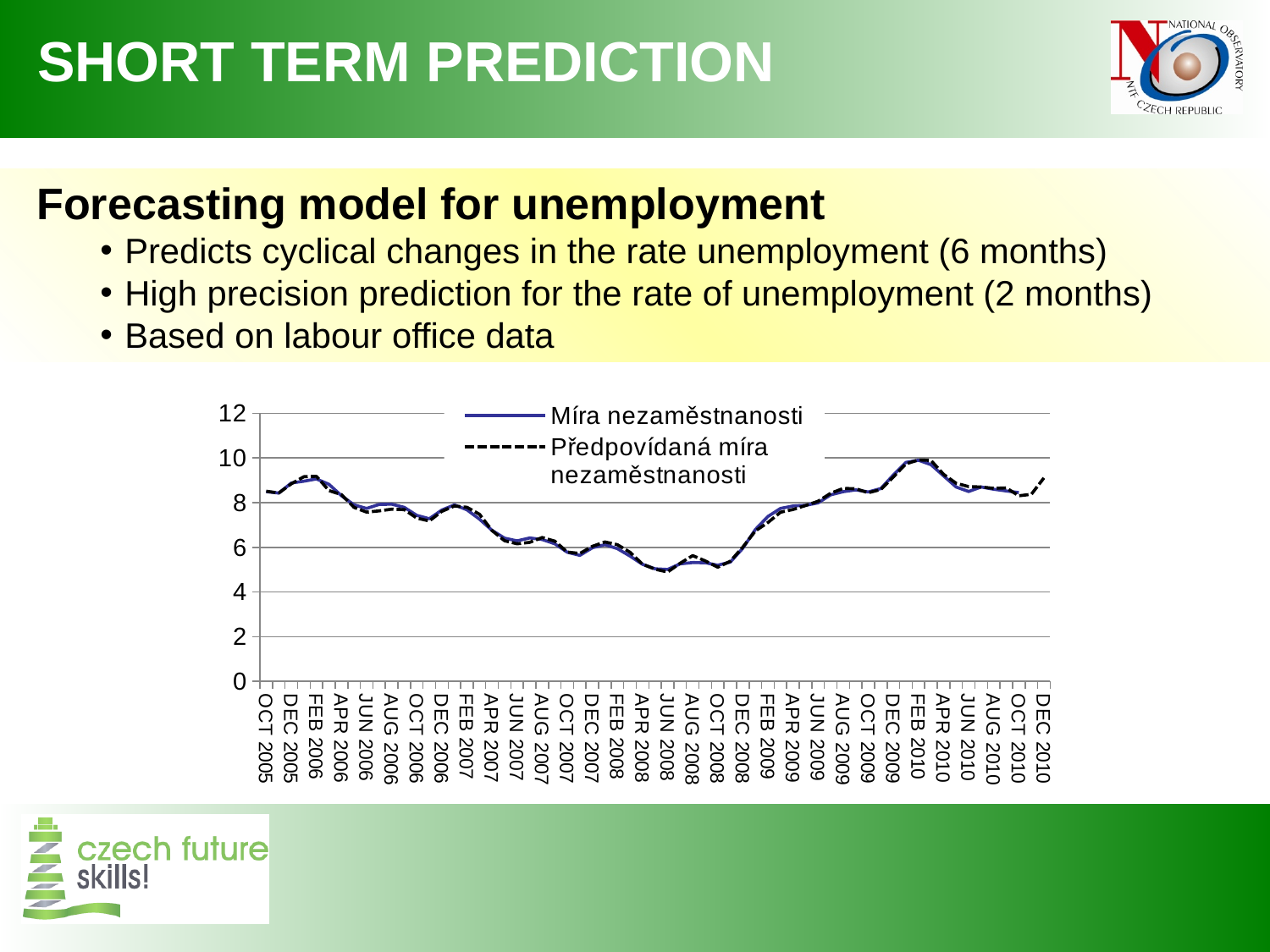
Which series is drawn as a dashed line? Předpovídaná míra nezaměstnanosti Around which x-axis label does Míra nezaměstnanosti reach its highest value? FEB 2010 Which is larger for Míra nezaměstnanosti: the value at FEB 2010 or the value at JUN 2008? FEB 2010 What kind of chart is shown on the slide? line chart Around which x-axis label does Míra nezaměstnanosti reach its lowest value? JUN 2008 What are the two series named in the chart legend? Míra nezaměstnanosti; Předpovídaná míra nezaměstnanosti Is the value of Míra nezaměstnanosti at JUN 2008 greater or less than 6? less Is the value of Míra nezaměstnanosti at OCT 2007 greater or less than 8? less Is the value of Míra nezaměstnanosti at FEB 2010 greater or less than 8? greater How many series does the chart legend list? 2 Does Míra nezaměstnanosti rise or fall between FEB 2006 and JUN 2008? fall